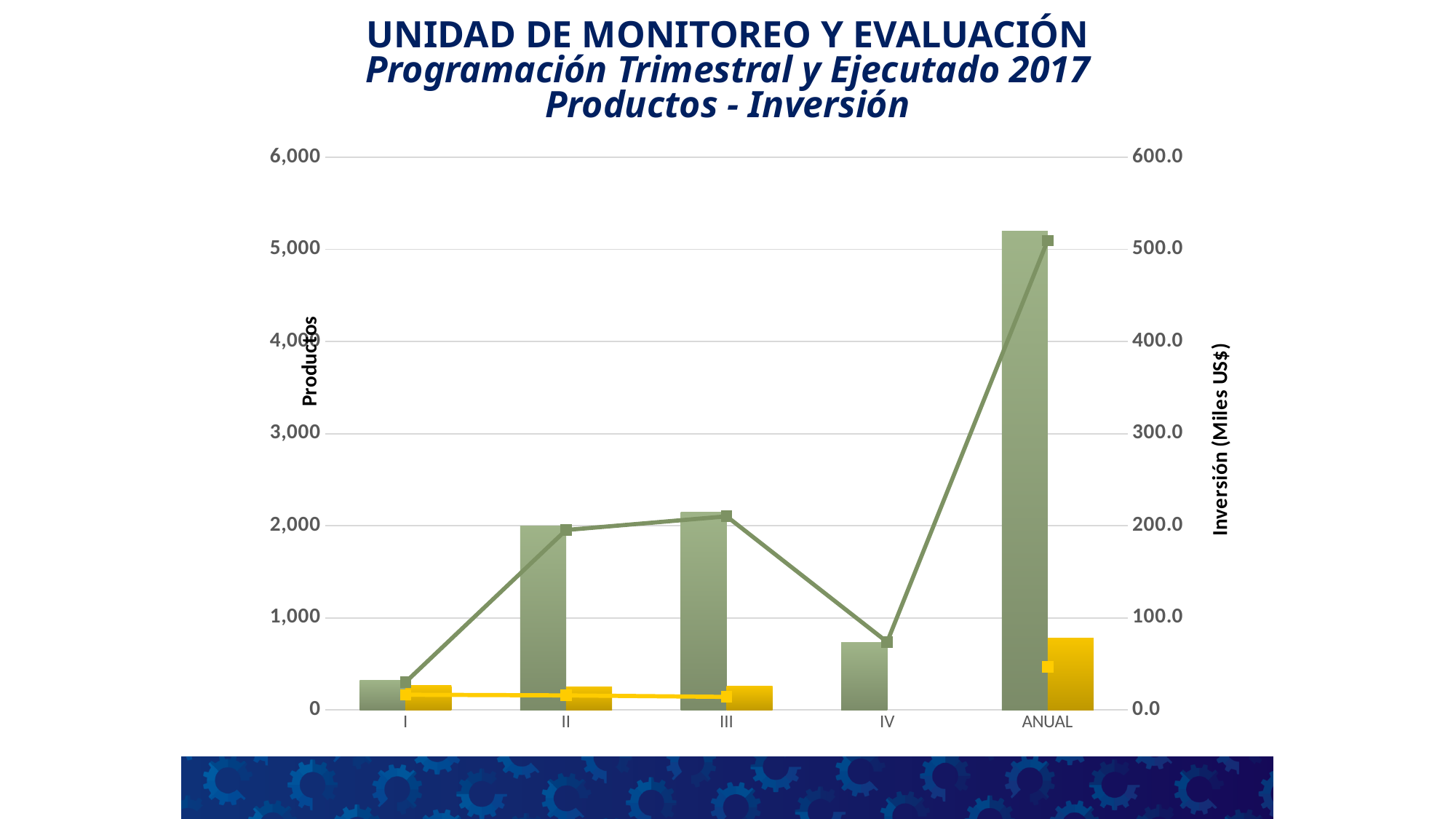
Which has the taller green bar, I or IV? IV What type of chart is shown on the slide? Bar chart with line series What is the title of the right vertical axis? Inversión (Miles US$) Is the green bar for II greater or less than 3,000 on the Productos axis? less Does the green line rise or fall from III to IV? fall Is the green bar for IV greater or less than 1,000 on the Productos axis? less Which category has the tallest yellow bar? ANUAL What is the title of the left vertical axis? Productos How many categories are shown on the x axis? 5 Is the green bar for ANUAL greater or less than 5,000 on the Productos axis? greater Which category has the shortest green bar? I Which category has the tallest green bar? ANUAL